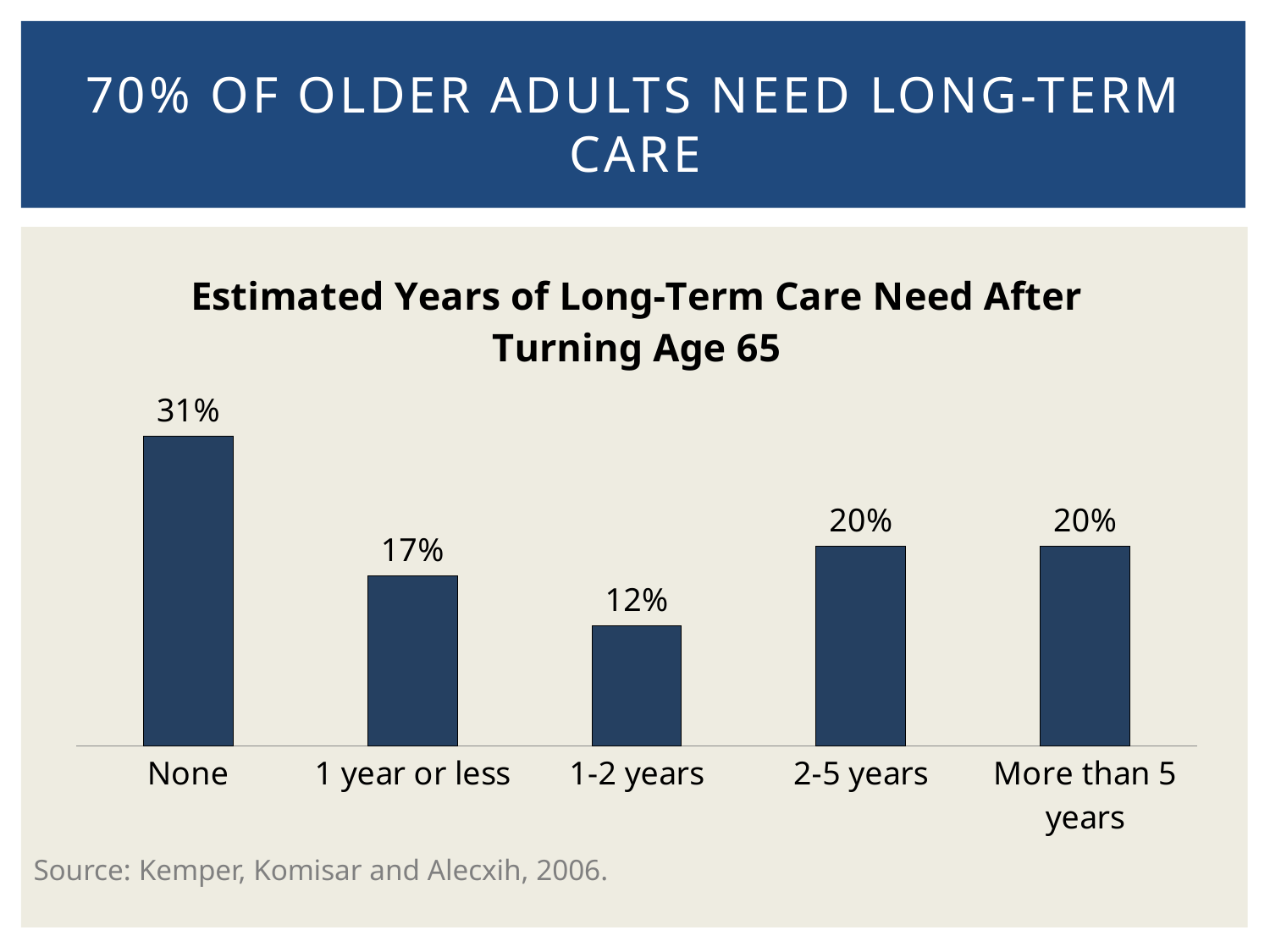
How many categories are shown on the x axis? 5 Which category has the highest value? None What is the value for "More than 5 years"? 20% What is the value for "1 year or less"? 17% What is the value for "2-5 years"? 20% What is the title of the chart? Estimated Years of Long-Term Care Need After Turning Age 65 What kind of chart is shown on the slide? Bar chart What is the value for "None"? 31% What is the difference between the values for "None" and "1-2 years"? 19% What is the value for "1-2 years"? 12% Which category has the lowest value? 1-2 years Which is larger, the value for "1 year or less" or the value for "2-5 years"? 2-5 years